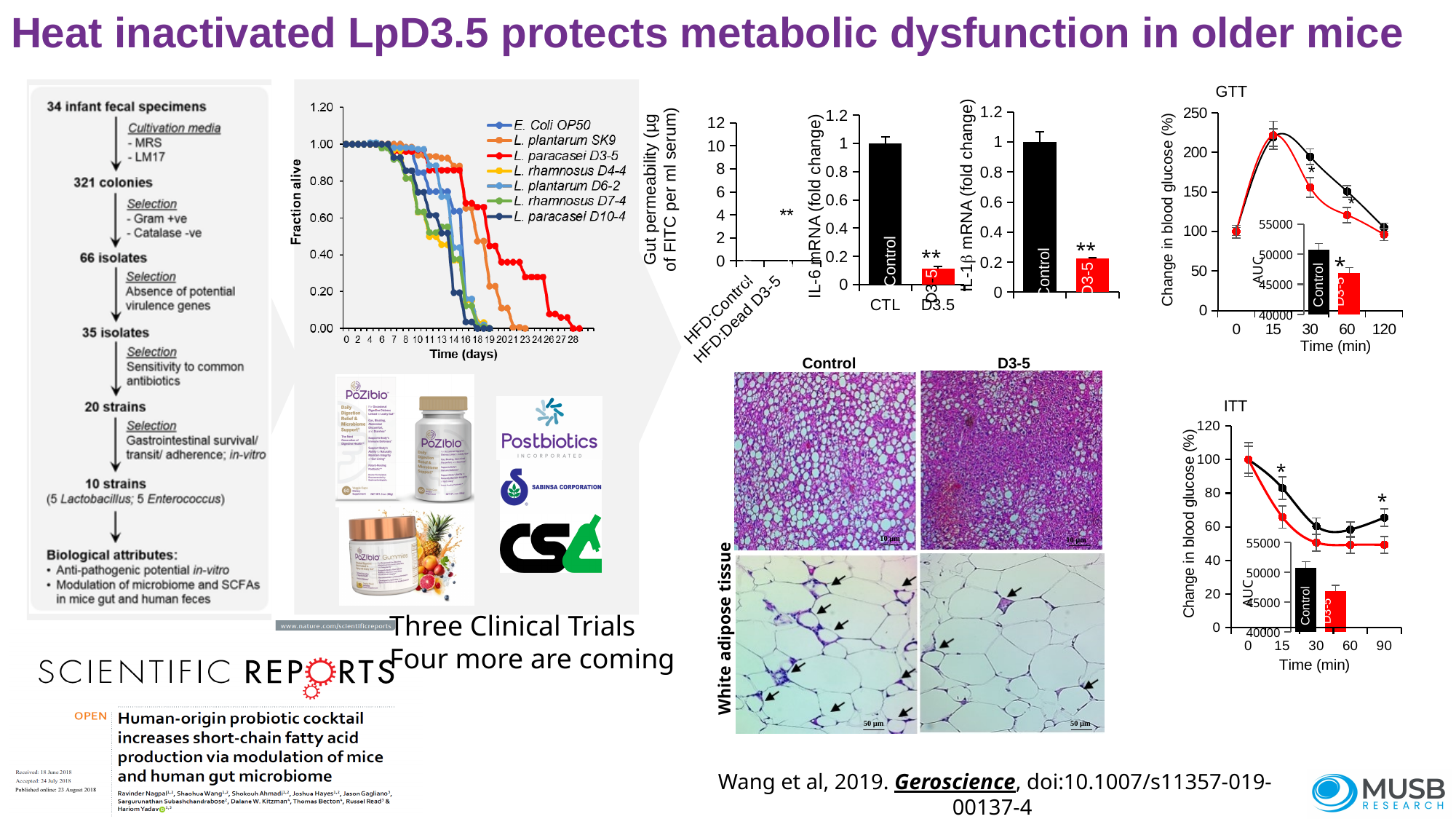
What kind of chart is the Fraction alive vs Time (days) chart? line chart In the GTT chart, at which time point (min) do both curves reach their peak? 15 In the AUC inset of the ITT chart, is the value for D3-5 greater or less than 50000? less In the survival chart (Fraction alive vs Time in days), which strain's curve extends the furthest in time before reaching zero? L. paracasei D3-5 In the Gut permeability bar chart, how many categories are shown on the x axis? 2 In the survival chart (Fraction alive vs Time in days), how many series does the legend list? 7 In the IL-6 mRNA (fold change) bar chart, is the value for D3-5 greater or less than 0.2? less In the IL-1β mRNA (fold change) bar chart, which bar is taller, Control or D3-5? Control In the survival chart (Fraction alive vs Time in days), what is the label of the x axis? Time (days) In the ITT chart, how many time points are marked on the x axis? 5